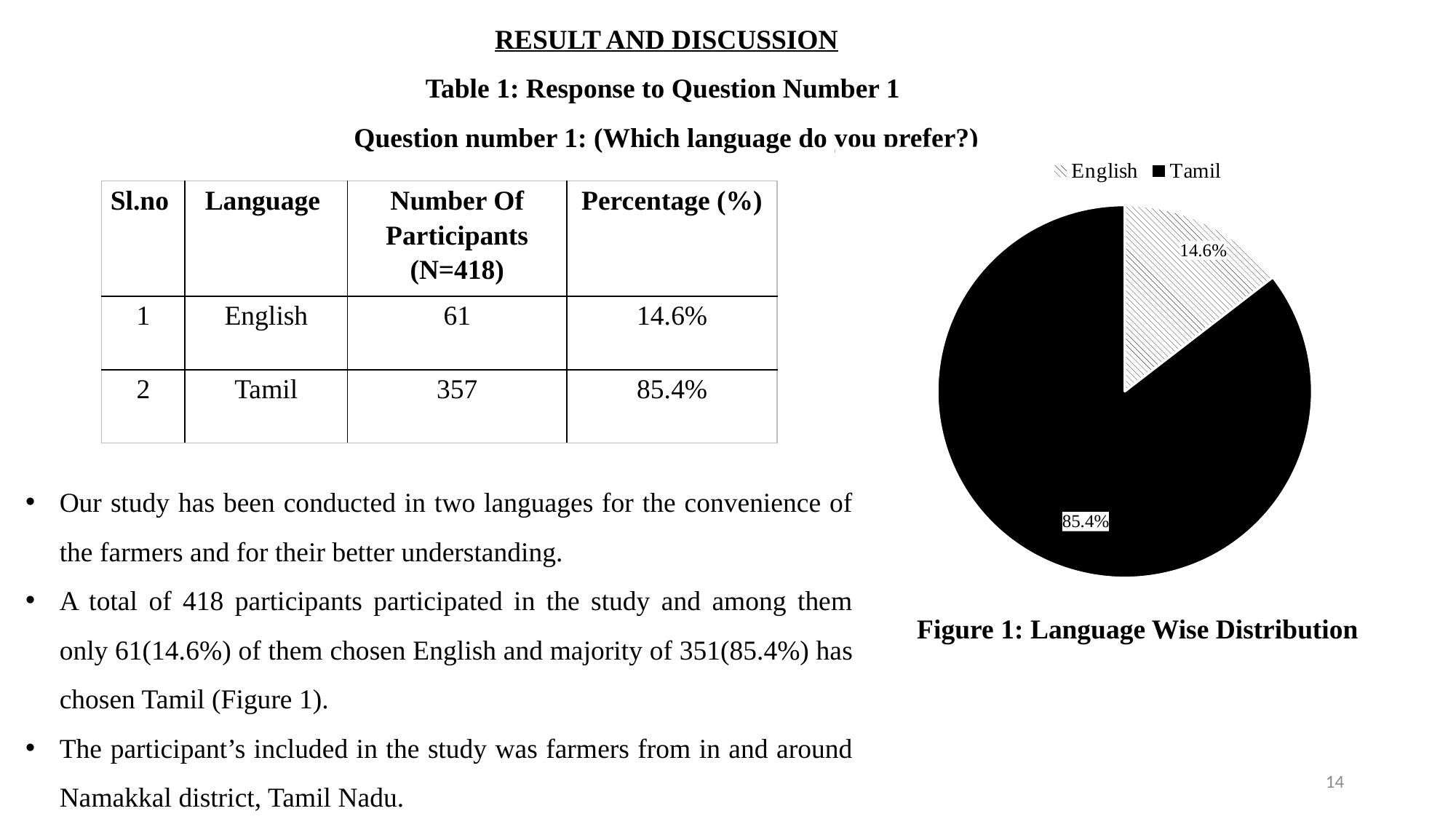
What is the difference in percentage points between the Tamil and English slices in the pie chart? 70.8 How many entries does the legend of the pie chart list? 2 What kind of chart is Figure 1: Language Wise Distribution? pie chart Which slice is larger in the pie chart, English or Tamil? Tamil Which language has the largest slice in the pie chart? Tamil What is the caption of the pie chart on the slide? Figure 1: Language Wise Distribution How many slices does the pie chart have? 2 In the pie chart, which language is shown with a hatched (striped) pattern? English In the pie chart, what share does Tamil have? 85.4% Which language has the smallest slice in the pie chart? English In the pie chart, what share does English have? 14.6%